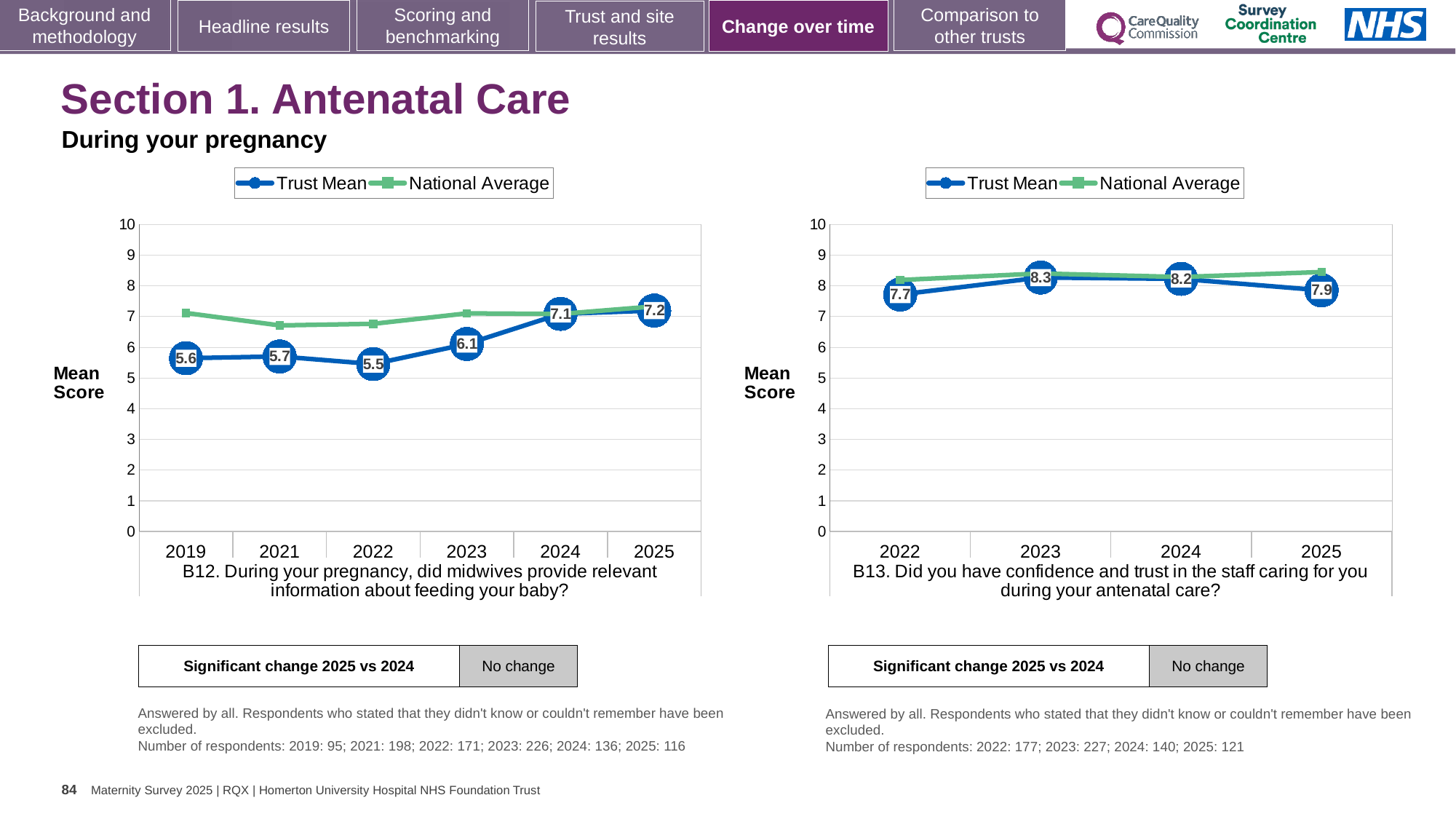
In the right chart (B13), which year has the lowest Trust Mean score? 2022 In the left chart (B12), is the National Average for 2021 greater or less than 7? less In the left chart (B12), how many years are shown on the x axis? 6 In the left chart (B12), which year has the lowest Trust Mean score? 2022 What kind of chart is the left chart (B12)? Line chart In the left chart (B12), what is the difference between the Trust Mean scores for 2025 and 2019? 1.6 In the right chart (B13), is the Trust Mean score for 2024 larger than the score for 2025? Yes In the right chart (B13), what is the difference between the Trust Mean scores for 2023 and 2022? 0.6 In the left chart (B12), what is the Trust Mean score for 2025? 7.2 How many series does the legend of the right chart (B13) list? 2 In the right chart (B13), what is the Trust Mean score for 2023? 8.3 In the left chart (B12), what is the Trust Mean score for 2019? 5.6